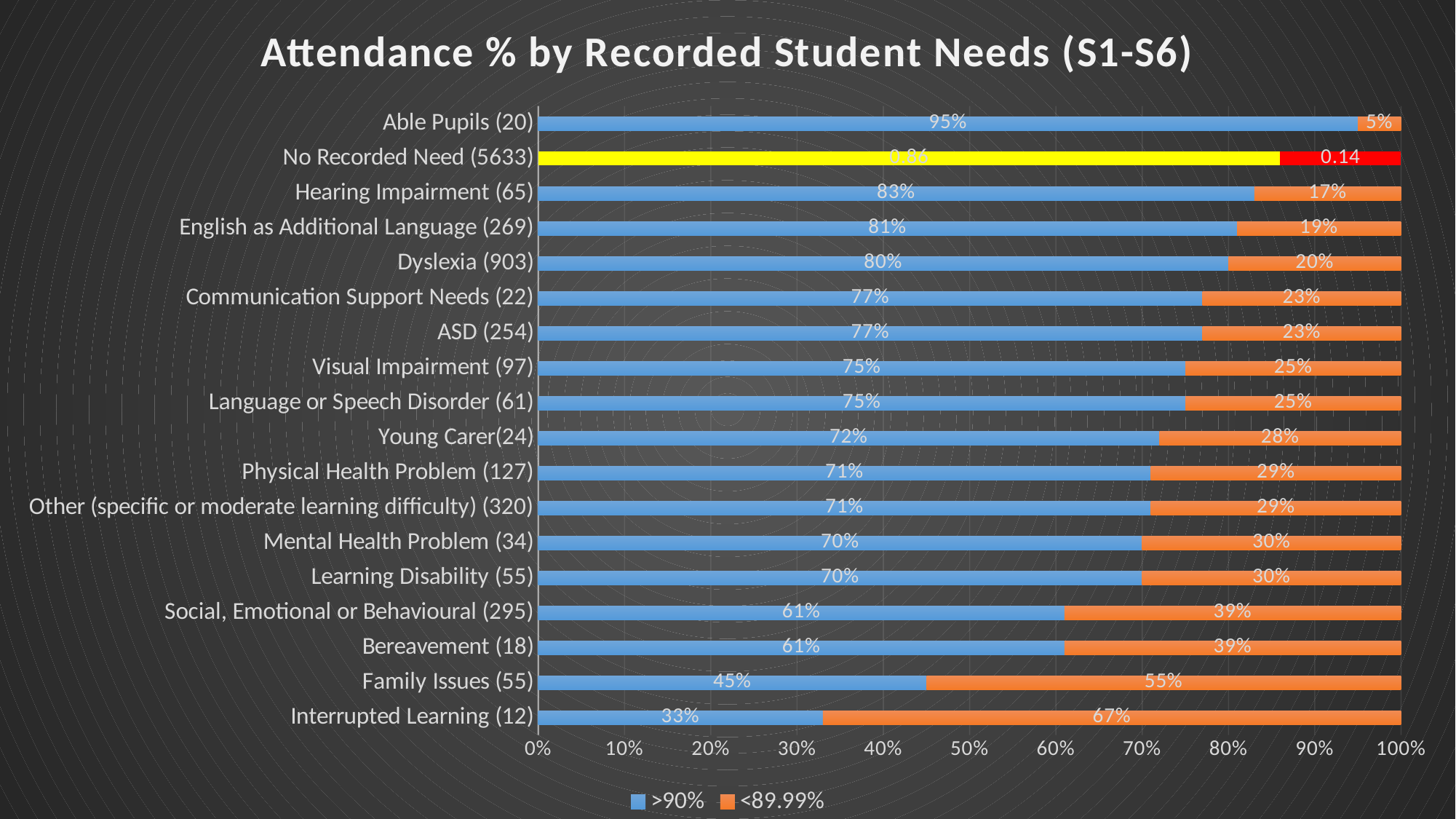
What is the >90% value for Dyslexia (903)? 80% What is the >90% value for Hearing Impairment (65)? 83% Which category's bar is highlighted in yellow and red instead of blue and orange? No Recorded Need (5633) How many categories are shown on the chart? 18 What is the <89.99% value for Family Issues (55)? 55% Which has a larger >90% value, Young Carer(24) or Bereavement (18)? Young Carer(24) Which category has the lowest >90% value? Interrupted Learning (12) Which category has the highest <89.99% value? Interrupted Learning (12) What kind of chart is shown on the slide? Stacked bar chart Which category has the highest >90% value? Able Pupils (20) How many series does the legend list? 2 What is the difference between the >90% values for Able Pupils (20) and Interrupted Learning (12)? 62%